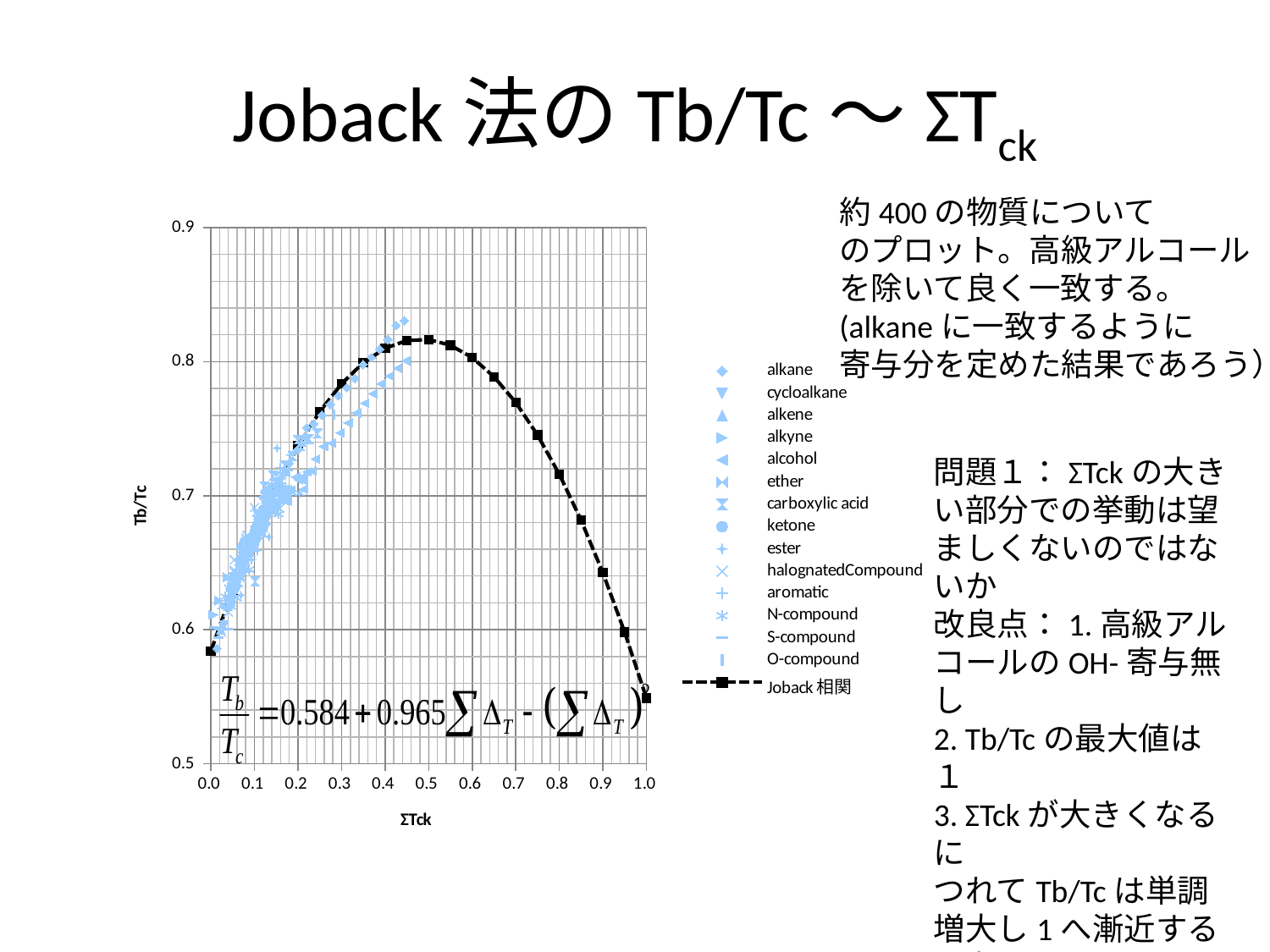
Does the Joback 相関 line rise or fall as ΣTck increases from 0.5 to 1.0? fall Is the value of the Joback 相関 line at ΣTck = 0.0 greater or less than 0.6? less What kind of chart is shown on the slide? scatter chart What is the title of the y axis? Tb/Tc What is the title of the x axis? ΣTck How many series does the legend list? 15 Which is larger for the Joback 相関 line: the value at ΣTck = 0.5 or the value at ΣTck = 1.0? ΣTck = 0.5 Does the Joback 相関 line rise or fall as ΣTck increases from 0.0 to 0.5? rise How many tick labels are shown on the x axis? 11 Is the value of the Joback 相関 line at ΣTck = 1.0 greater or less than 0.6? less Is the value of the Joback 相関 line at ΣTck = 0.5 greater or less than 0.8? greater